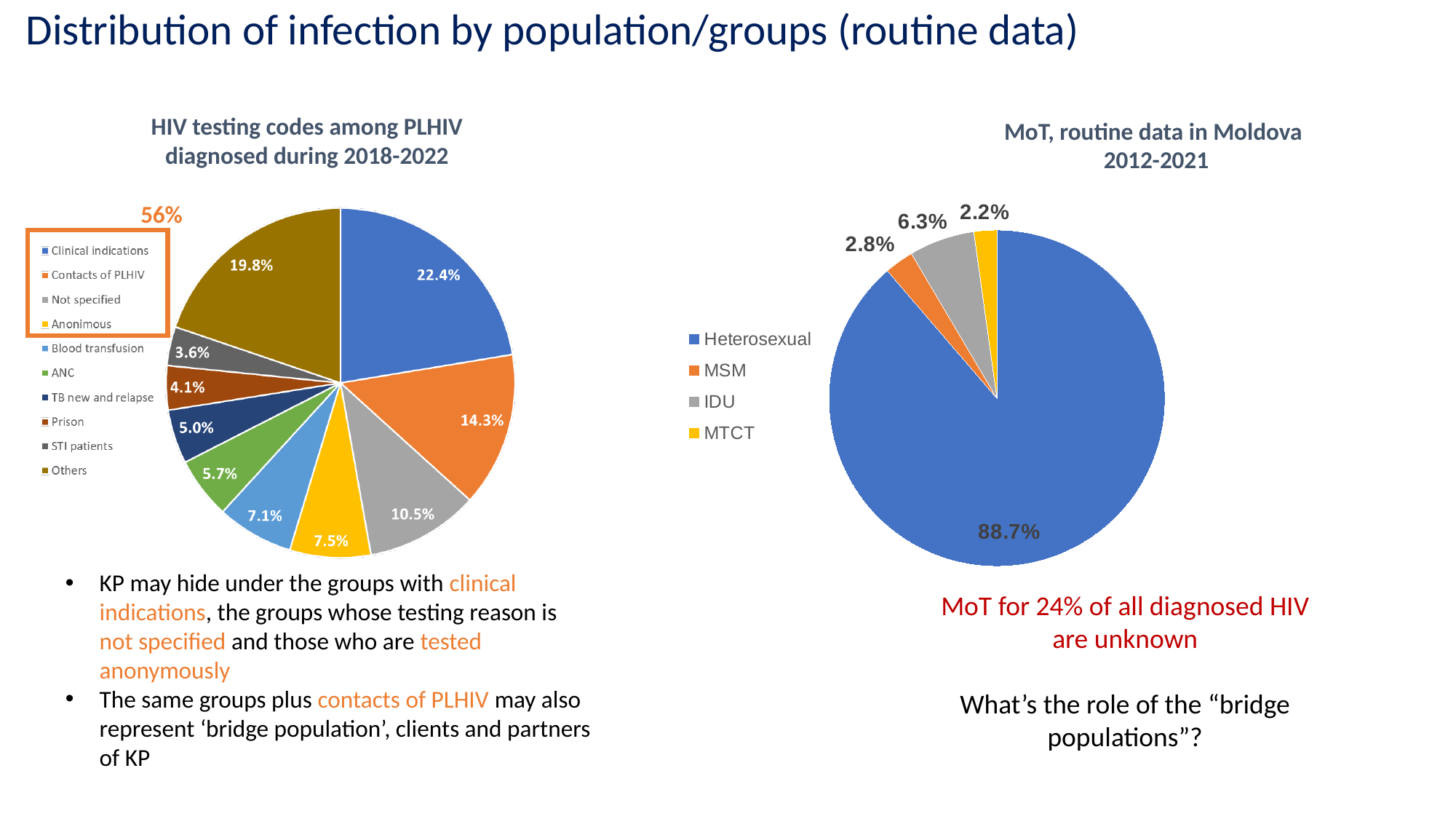
In the 'MoT, routine data in Moldova 2012-2021' chart, what share is labelled for Heterosexual? 88.7% In the 'HIV testing codes among PLHIV diagnosed during 2018-2022' chart, what is the difference between the Others slice and the Not specified slice? 9.3% In the 'HIV testing codes among PLHIV diagnosed during 2018-2022' chart, how many categories does the legend list? 10 In the 'MoT, routine data in Moldova 2012-2021' chart, what share is labelled for IDU? 6.3% In the 'HIV testing codes among PLHIV diagnosed during 2018-2022' chart, which category has the largest slice? Clinical indications In the 'MoT, routine data in Moldova 2012-2021' chart, which category has the smallest slice? MTCT In the 'HIV testing codes among PLHIV diagnosed during 2018-2022' chart, which category has the smallest slice? STI patients In the 'HIV testing codes among PLHIV diagnosed during 2018-2022' chart, which is larger: the ANC slice or the Prison slice? ANC What type of chart is 'MoT, routine data in Moldova 2012-2021'? Pie chart In the 'MoT, routine data in Moldova 2012-2021' chart, what is the difference between the MSM slice and the MTCT slice? 0.6% In the 'HIV testing codes among PLHIV diagnosed during 2018-2022' chart, what share is labelled for Contacts of PLHIV? 14.3% In the 'HIV testing codes among PLHIV diagnosed during 2018-2022' chart, what share is labelled for Clinical indications? 22.4%